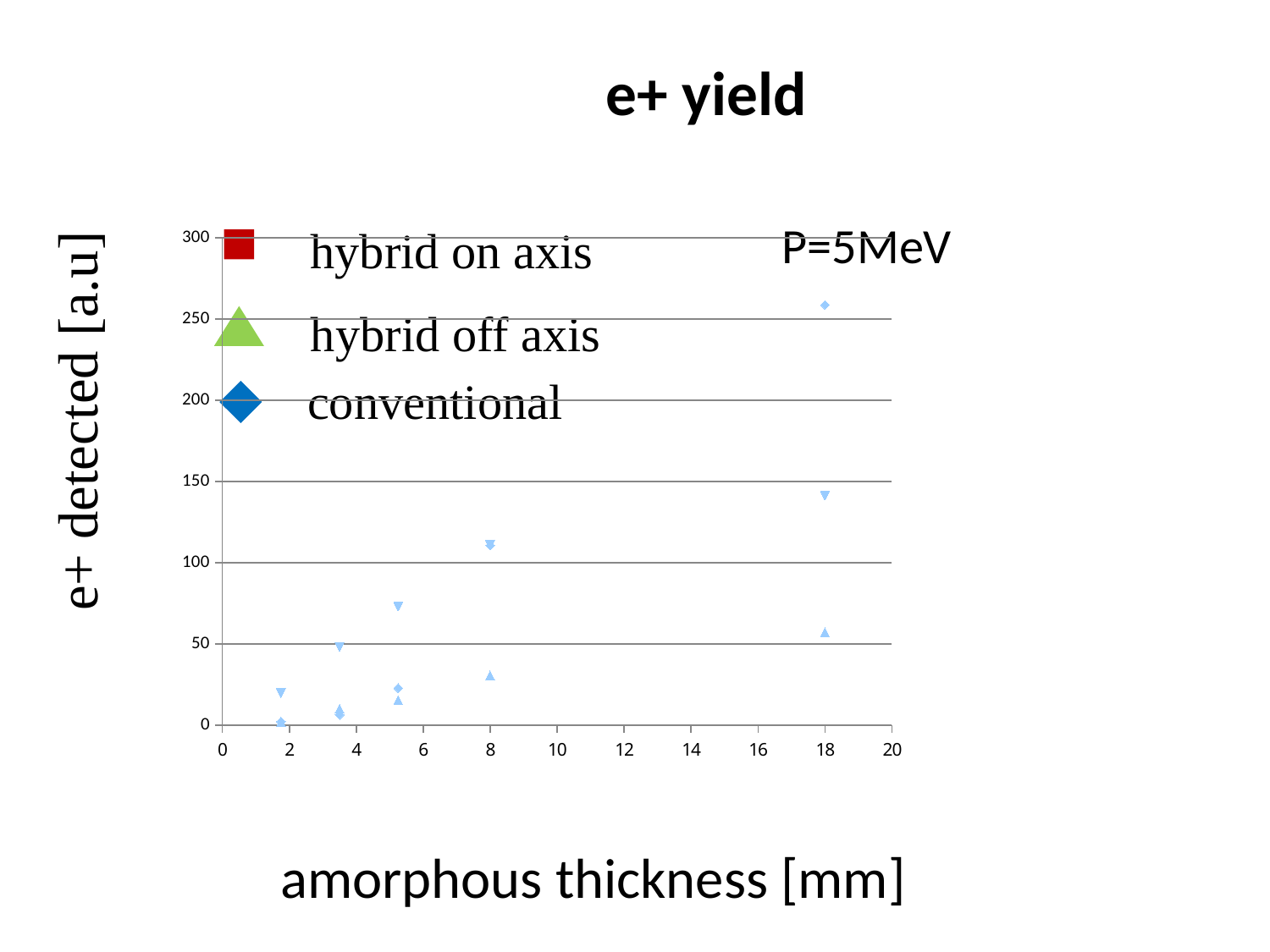
What is the title of the chart? e+ yield Is the value of the downward-pointing triangle marker at an amorphous thickness of 8 mm greater or less than 100? greater How many series does the legend list? 3 Is the value of the upward-pointing triangle marker at an amorphous thickness of 8 mm greater or less than 50? less Do the plotted values generally rise or fall as amorphous thickness increases? rise Is the value of the upward-pointing triangle marker at an amorphous thickness of 18 mm greater or less than 50? greater What is the highest tick value shown on the y axis? 300 What kind of chart is shown on the slide? scatter chart What is the label of the x axis? amorphous thickness [mm] At an amorphous thickness of 18 mm, which marker has the larger value: the diamond or the upward-pointing triangle? the diamond